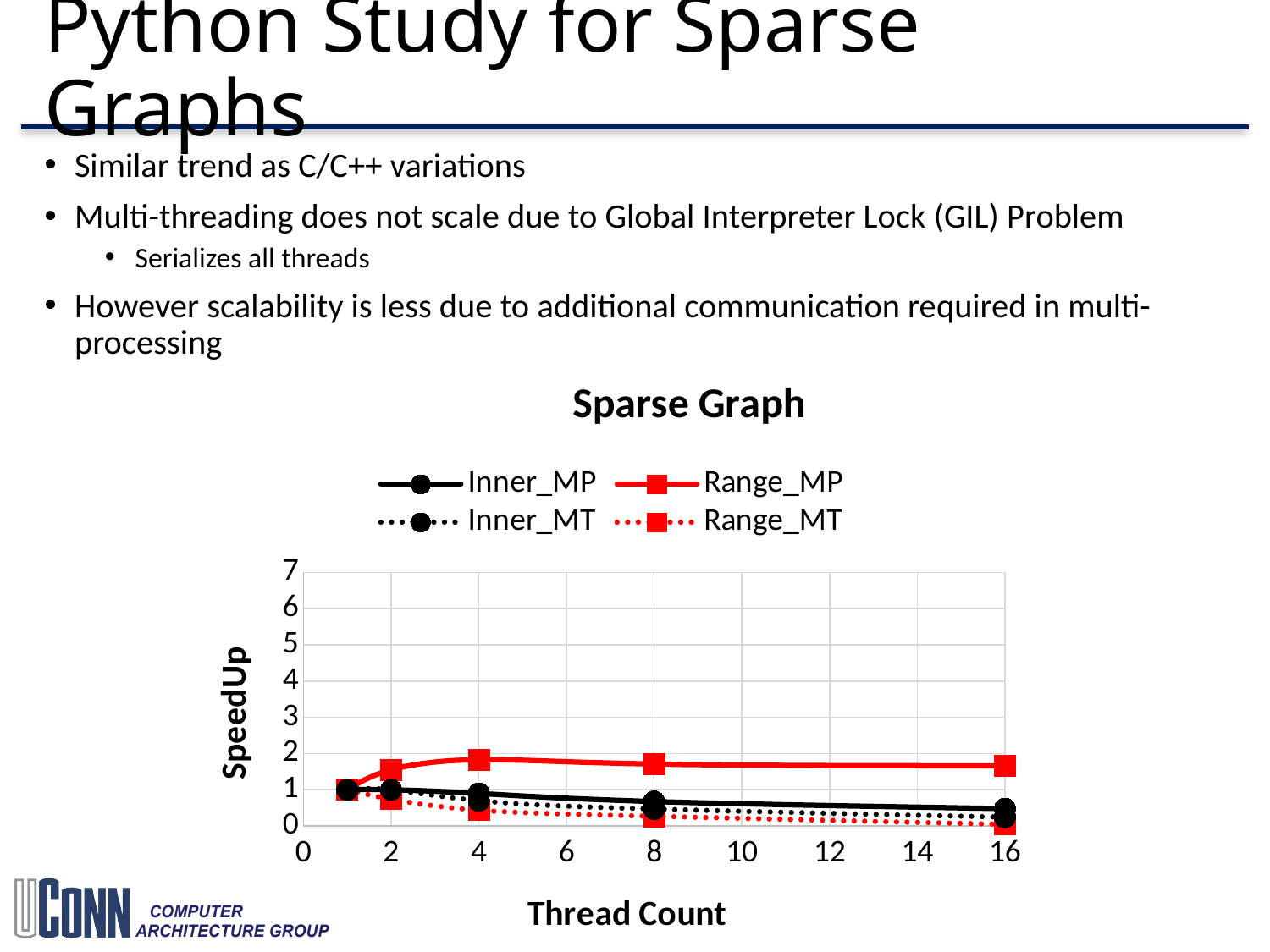
What is the label of the y axis? SpeedUp What kind of chart is shown on the slide? line chart Is the SpeedUp value for Range_MP at a thread count of 16 greater or less than 1? greater What is the highest tick value shown on the y axis? 7 Which series has the highest SpeedUp at a thread count of 16? Range_MP Does the SpeedUp for Inner_MT rise or fall as the thread count increases from 1 to 16? fall What is the title of the chart? Sparse Graph Is the SpeedUp value for Inner_MP at a thread count of 16 greater or less than 1? less How many series does the chart legend list? 4 How many data points are plotted for the Range_MP series? 5 Is the SpeedUp value for Range_MT at a thread count of 8 greater or less than 1? less At a thread count of 8, which series has the higher SpeedUp, Range_MP or Inner_MP? Range_MP